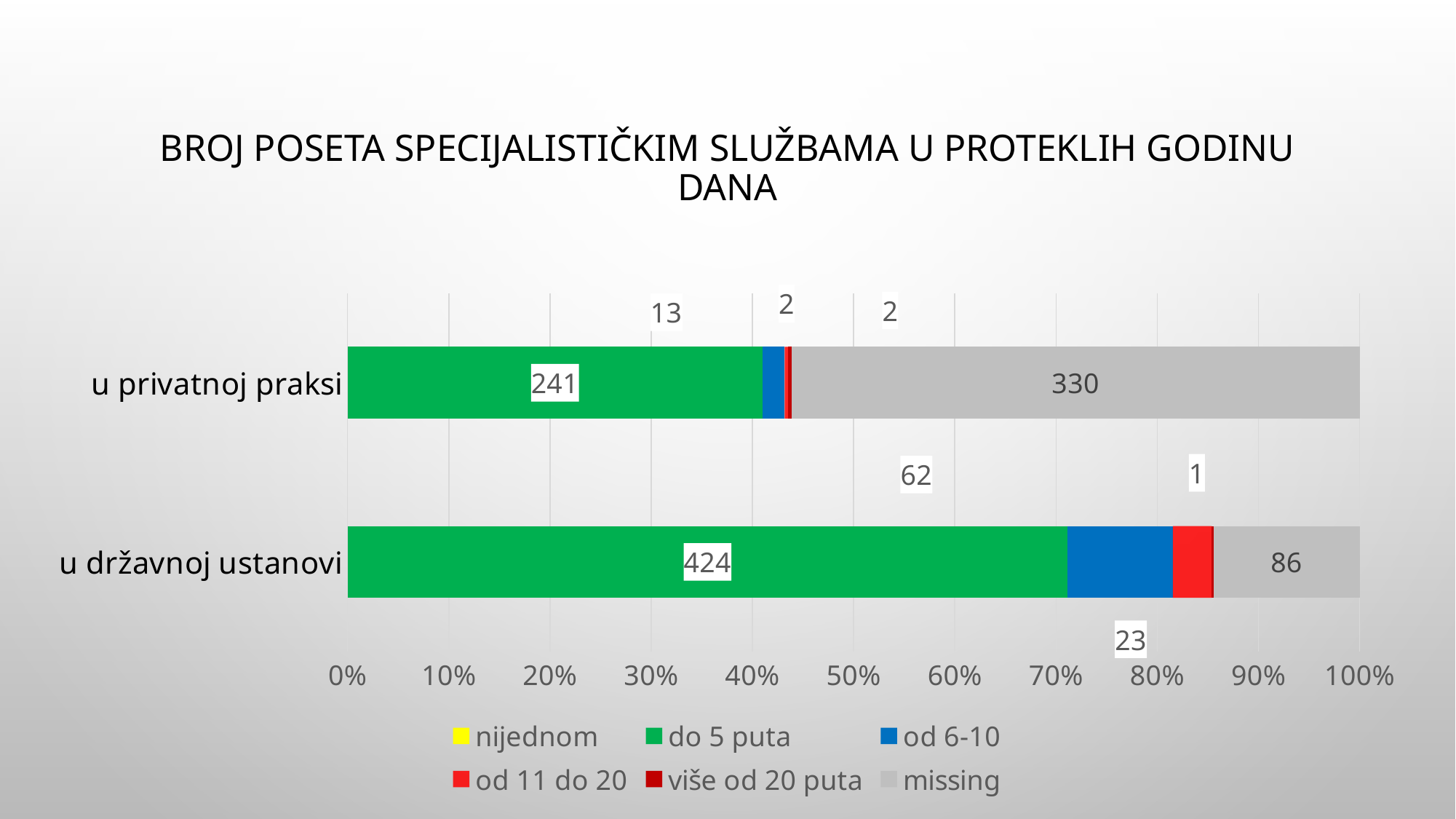
What is the value of "missing" for "u državnoj ustanovi"? 86 What is the value of "do 5 puta" for "u državnoj ustanovi"? 424 What kind of chart is shown on the slide? Stacked bar chart Which category has the larger "missing" value, "u privatnoj praksi" or "u državnoj ustanovi"? u privatnoj praksi What is the value of "missing" for "u privatnoj praksi"? 330 What is the value of "od 11 do 20" for "u državnoj ustanovi"? 23 How many series does the legend list? 6 What is the value of "do 5 puta" for "u privatnoj praksi"? 241 How many categories are shown on the vertical axis? 2 What is the difference between the "do 5 puta" values for "u državnoj ustanovi" and "u privatnoj praksi"? 183 What is the difference between the "missing" values for "u privatnoj praksi" and "u državnoj ustanovi"? 244 What is the value of "od 6-10" for "u državnoj ustanovi"? 62